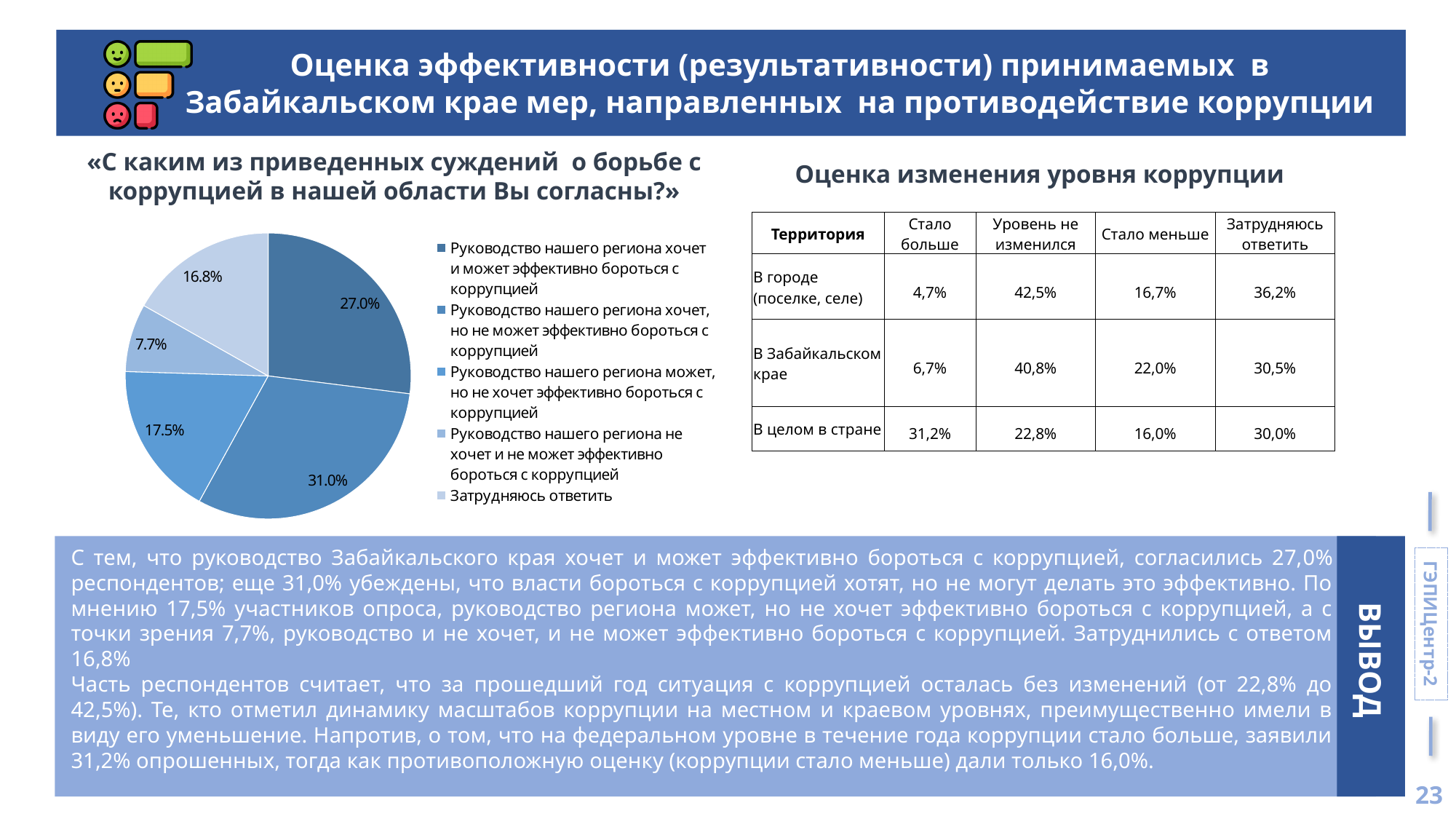
What type of chart is shown on the slide? Pie chart What percentage of respondents chose "Затрудняюсь ответить" in the pie chart? 16.8% Which is larger: the share for "Руководство нашего региона может, но не хочет эффективно бороться с коррупцией" or the share for "Затрудняюсь ответить"? Руководство нашего региона может, но не хочет эффективно бороться с коррупцией What is the difference in percentage points between the "хочет, но не может" slice and the "хочет и может" slice? 4.0 percentage points What is the title of the pie chart? «С каким из приведенных суждений о борьбе с коррупцией в нашей области Вы согласны?» How many entries does the pie chart legend list? 5 What percentage of respondents agreed that "Руководство нашего региона не хочет и не может эффективно бороться с коррупцией"? 7.7% Which statement has the largest share in the pie chart? Руководство нашего региона хочет, но не может эффективно бороться с коррупцией What percentage of respondents agreed that "Руководство нашего региона хочет и может эффективно бороться с коррупцией"? 27.0% Which statement has the smallest share in the pie chart? Руководство нашего региона не хочет и не может эффективно бороться с коррупцией What is the difference in percentage points between the "может, но не хочет" slice (17.5%) and the "не хочет и не может" slice (7.7%)? 9.8 percentage points How many slices does the pie chart have? 5